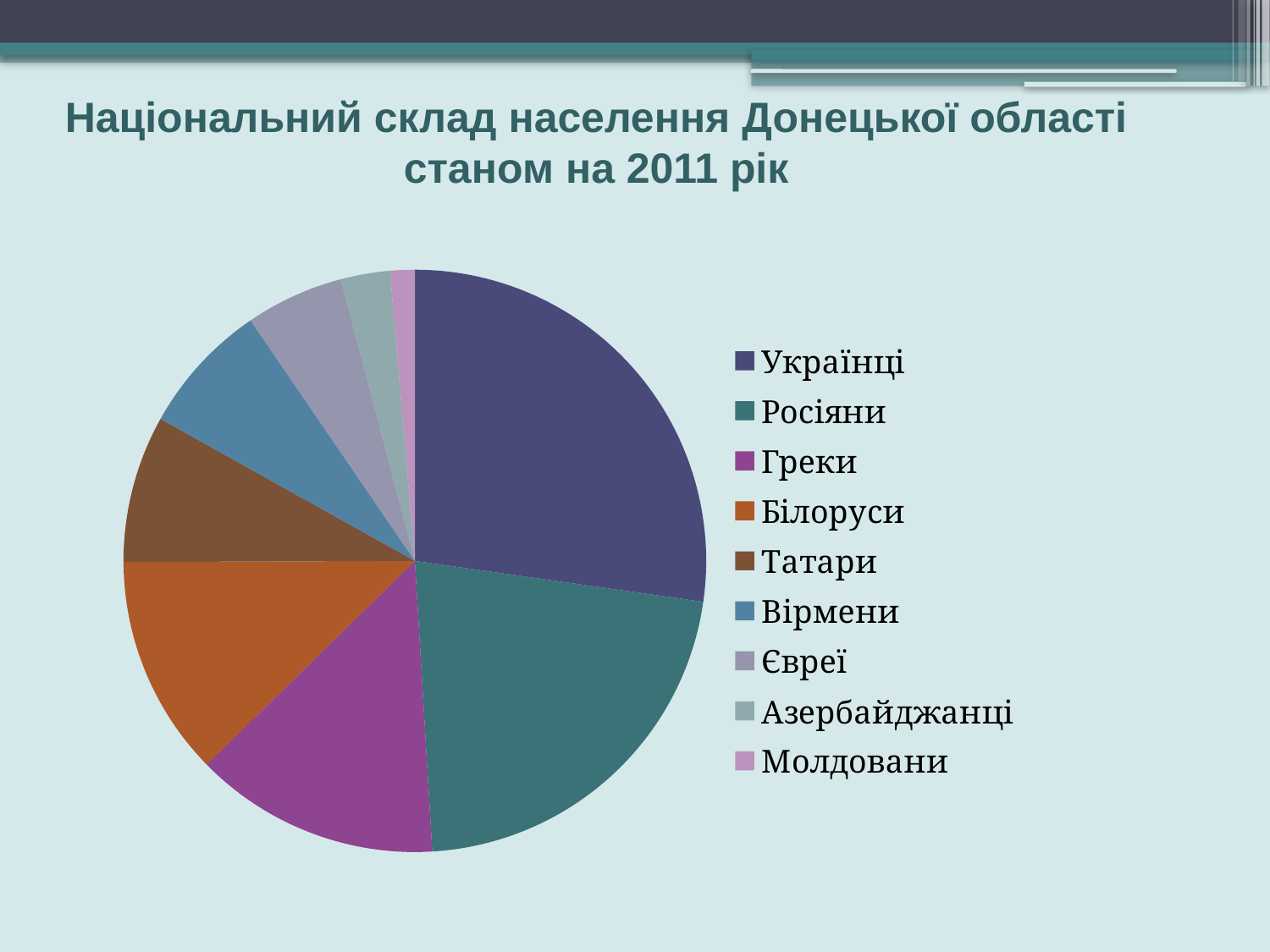
Which slice is larger, Росіяни or Греки? Росіяни Which category has the smallest slice of the pie? Молдовани Which slice is larger, Татари or Азербайджанці? Татари Which slice is larger, Греки or Вірмени? Греки Which category has the largest slice of the pie? Українці How many categories (slices) does the pie chart have? 9 What is the title of the chart on the slide? Національний склад населення Донецької області станом на 2011 рік What kind of chart is shown on the slide? pie chart Which category is listed first in the legend? Українці